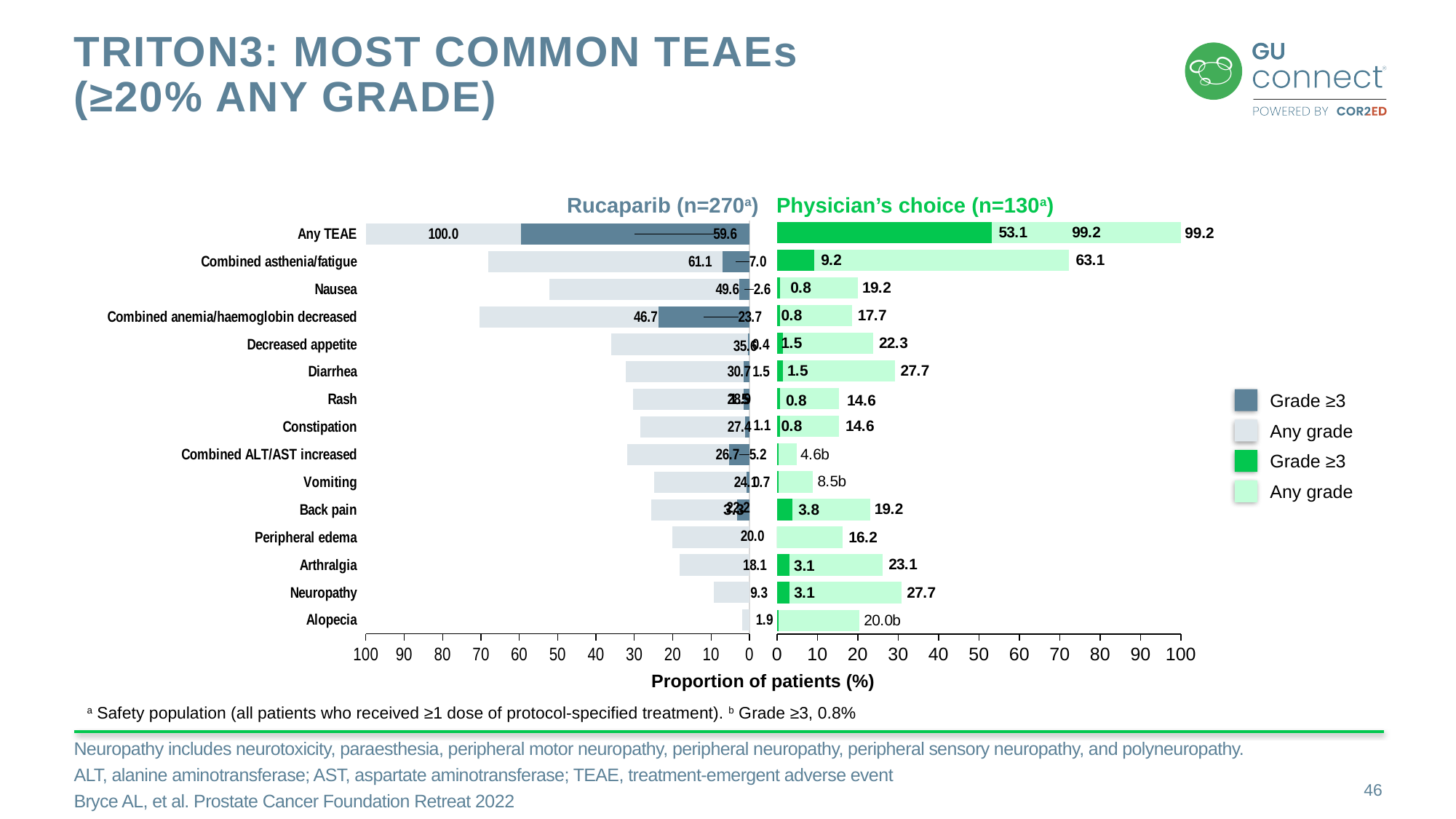
What is the x-axis title of the chart? Proportion of patients (%) How many entries does the chart legend list? 4 Which has a larger any-grade value for Neuropathy: Rucaparib or Physician's choice? Physician's choice In the Physician's choice (n=130) chart, which adverse event has the highest any-grade value? Any TEAE In the Rucaparib (n=270) chart, which adverse event has the lowest any-grade value? Alopecia In the Physician's choice (n=130) chart, what is the any-grade value for Combined asthenia/fatigue? 63.1 What is the difference between the any-grade Nausea values for Rucaparib (49.6) and Physician's choice (19.2)? 30.4 What type of chart is shown on the slide? bar chart How many adverse event categories are listed on the y axis of the chart? 15 In the Rucaparib (n=270) chart, what is the Grade ≥3 value for Combined anemia/haemoglobin decreased? 23.7 In the Physician's choice (n=130) chart, what is the Grade ≥3 value for Any TEAE? 53.1 In the Rucaparib (n=270) chart, what is the any-grade value for Combined asthenia/fatigue? 61.1